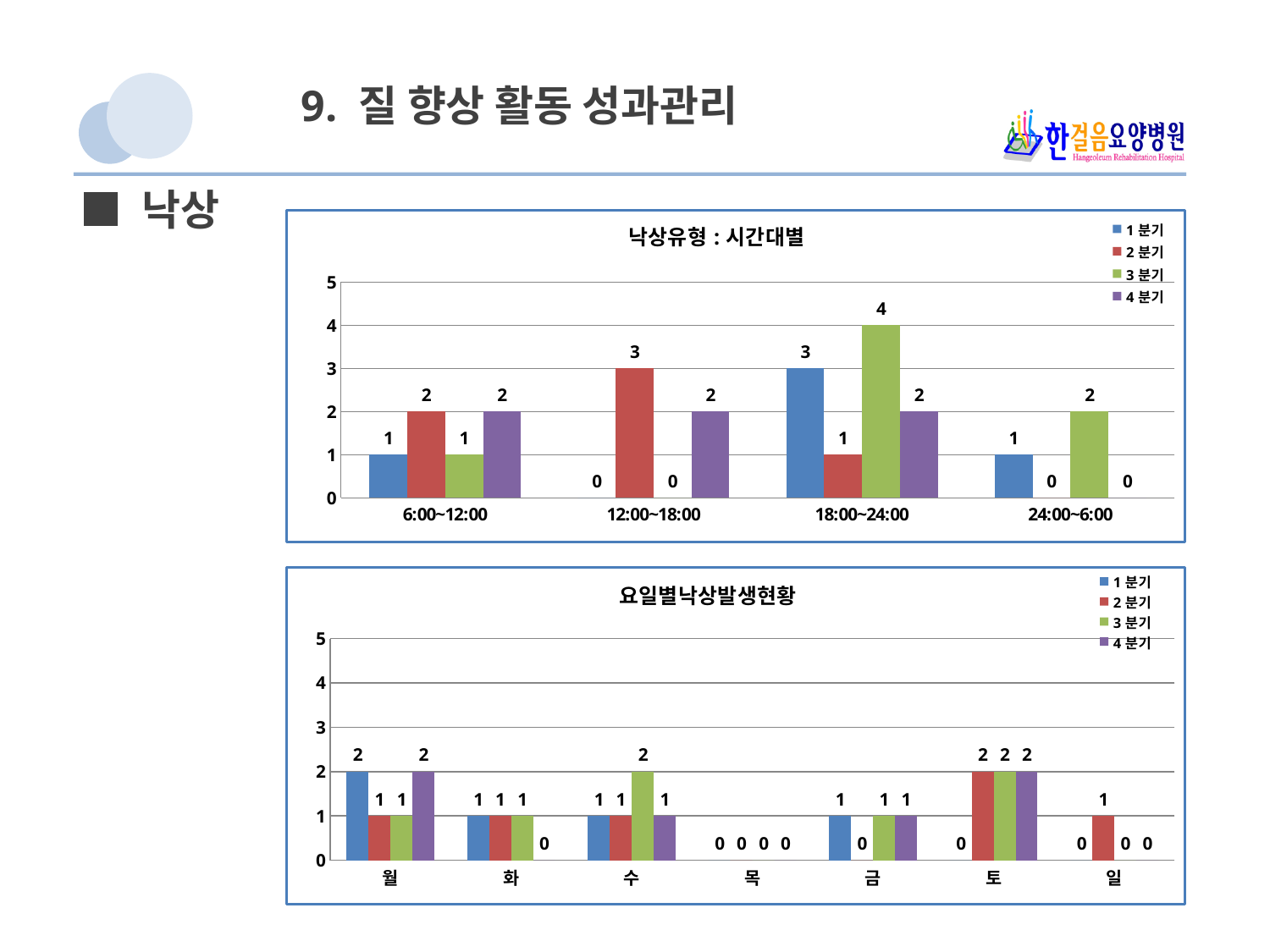
In the bottom chart (요일별낙상발생현황), which is larger: the 1 분기 value on 월 or the 1 분기 value on 화? 월 What type of chart is the top chart (낙상유형 : 시간대별)? Bar chart In the top chart (낙상유형 : 시간대별), what is the difference between the 3 분기 value and the 2 분기 value in the 18:00~24:00 category? 3 In the bottom chart (요일별낙상발생현황), how many day categories are shown on the x axis? 7 In the bottom chart (요일별낙상발생현황), what is the value for 2 분기 on 일? 1 In the top chart (낙상유형 : 시간대별), how many time categories are shown on the x axis? 4 In the top chart (낙상유형 : 시간대별), what is the value for 3 분기 in the 18:00~24:00 category? 4 In the bottom chart (요일별낙상발생현황), what is the value for 3 분기 on 수? 2 In the top chart (낙상유형 : 시간대별), what is the value for 2 분기 in the 12:00~18:00 category? 3 In the top chart (낙상유형 : 시간대별), how many series does the legend list? 4 In the bottom chart (요일별낙상발생현황), which day has a value of 0 for all four series? 목 In the top chart (낙상유형 : 시간대별), which time category has the highest value for 1 분기? 18:00~24:00